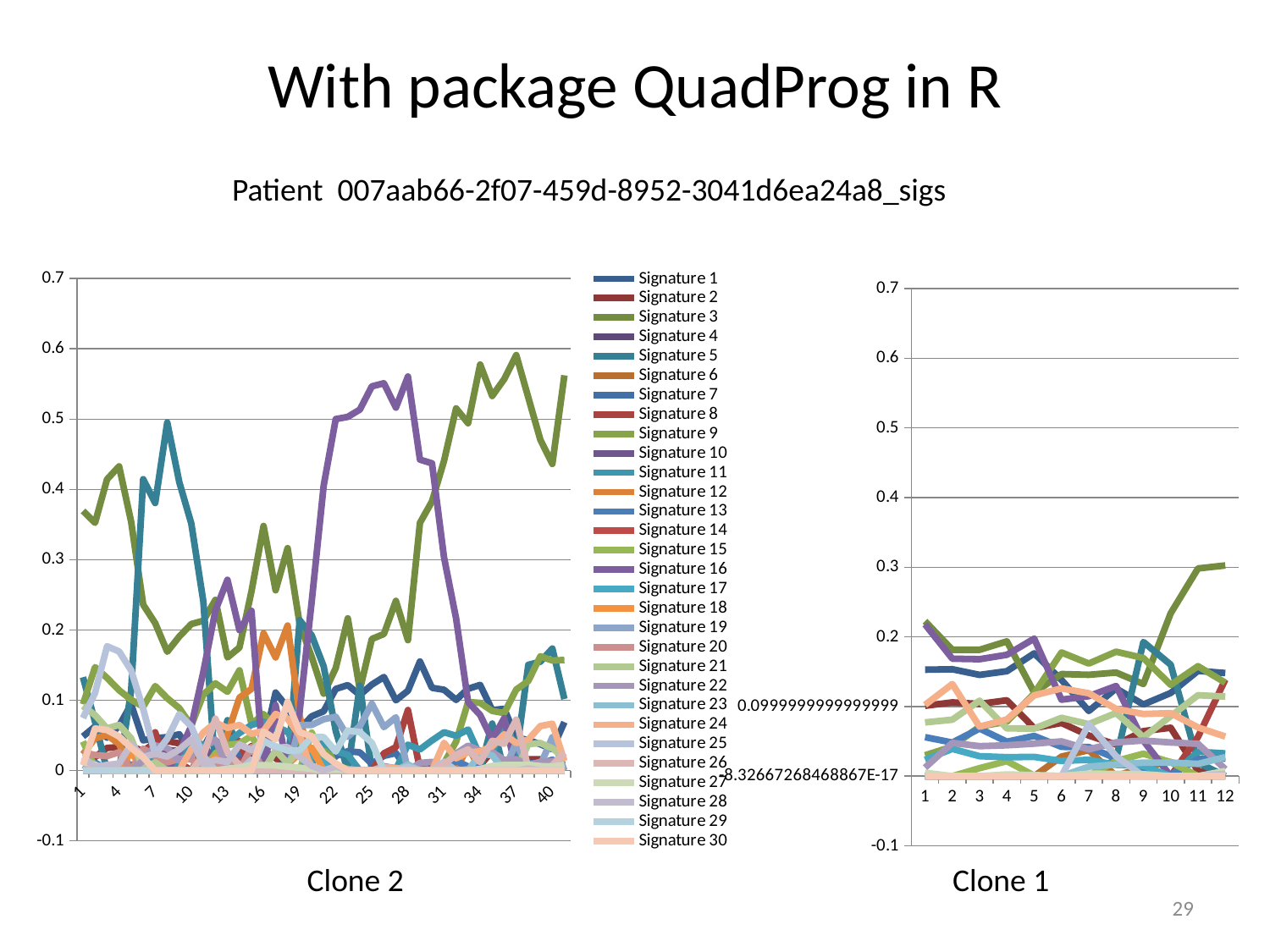
How many points are on the x axis of the Clone 1 chart? 12 What kind of chart is the Clone 2 chart on the left? line chart In the Clone 1 chart, is the value of the green line at point 12 greater or less than 0.2? greater In the Clone 1 chart, is the highest value of any line greater or less than 0.4? less In the Clone 2 chart, is the value of the green line at point 37 greater or less than 0.5? greater In the Clone 1 chart, does the green line rise or fall between point 9 and point 11? rise What kind of chart is the Clone 1 chart on the right? line chart In the Clone 2 chart, does the purple line rise or fall between point 28 and point 33? fall What is the lowest value shown on the y axis of the Clone 1 chart? -0.1 What is the highest value shown on the y axis of the Clone 2 chart? 0.7 How many series does the legend list? 30